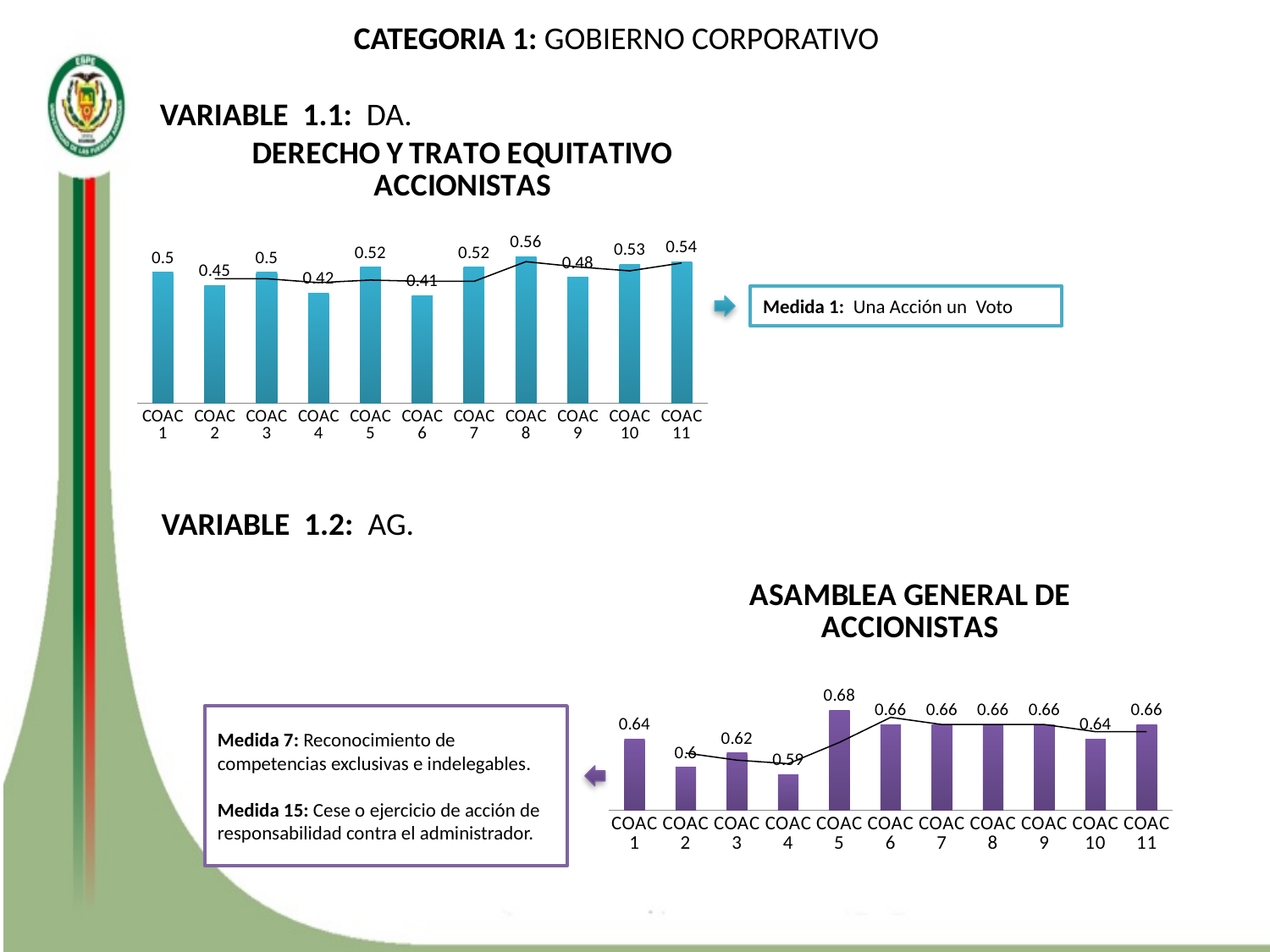
In the ASAMBLEA GENERAL DE ACCIONISTAS chart, what is the value for COAC 4? 0.59 In the DERECHO Y TRATO EQUITATIVO ACCIONISTAS chart, which COAC has the highest value? COAC 8 In the DERECHO Y TRATO EQUITATIVO ACCIONISTAS chart, what is the difference between the values for COAC 8 and COAC 6? 0.15 In the DERECHO Y TRATO EQUITATIVO ACCIONISTAS chart, which COAC has the lowest value? COAC 6 In the ASAMBLEA GENERAL DE ACCIONISTAS chart, which COAC has the highest value? COAC 5 In the DERECHO Y TRATO EQUITATIVO ACCIONISTAS chart, what is the value for COAC 8? 0.56 In the ASAMBLEA GENERAL DE ACCIONISTAS chart, which is larger, the value for COAC 1 or the value for COAC 2? COAC 1 In the DERECHO Y TRATO EQUITATIVO ACCIONISTAS chart, how many COAC categories are shown? 11 In the ASAMBLEA GENERAL DE ACCIONISTAS chart, which COAC has the lowest value? COAC 4 In the ASAMBLEA GENERAL DE ACCIONISTAS chart, what is the value for COAC 5? 0.68 In the DERECHO Y TRATO EQUITATIVO ACCIONISTAS chart, what is the value for COAC 6? 0.41 What kind of chart is the ASAMBLEA GENERAL DE ACCIONISTAS chart? Bar chart